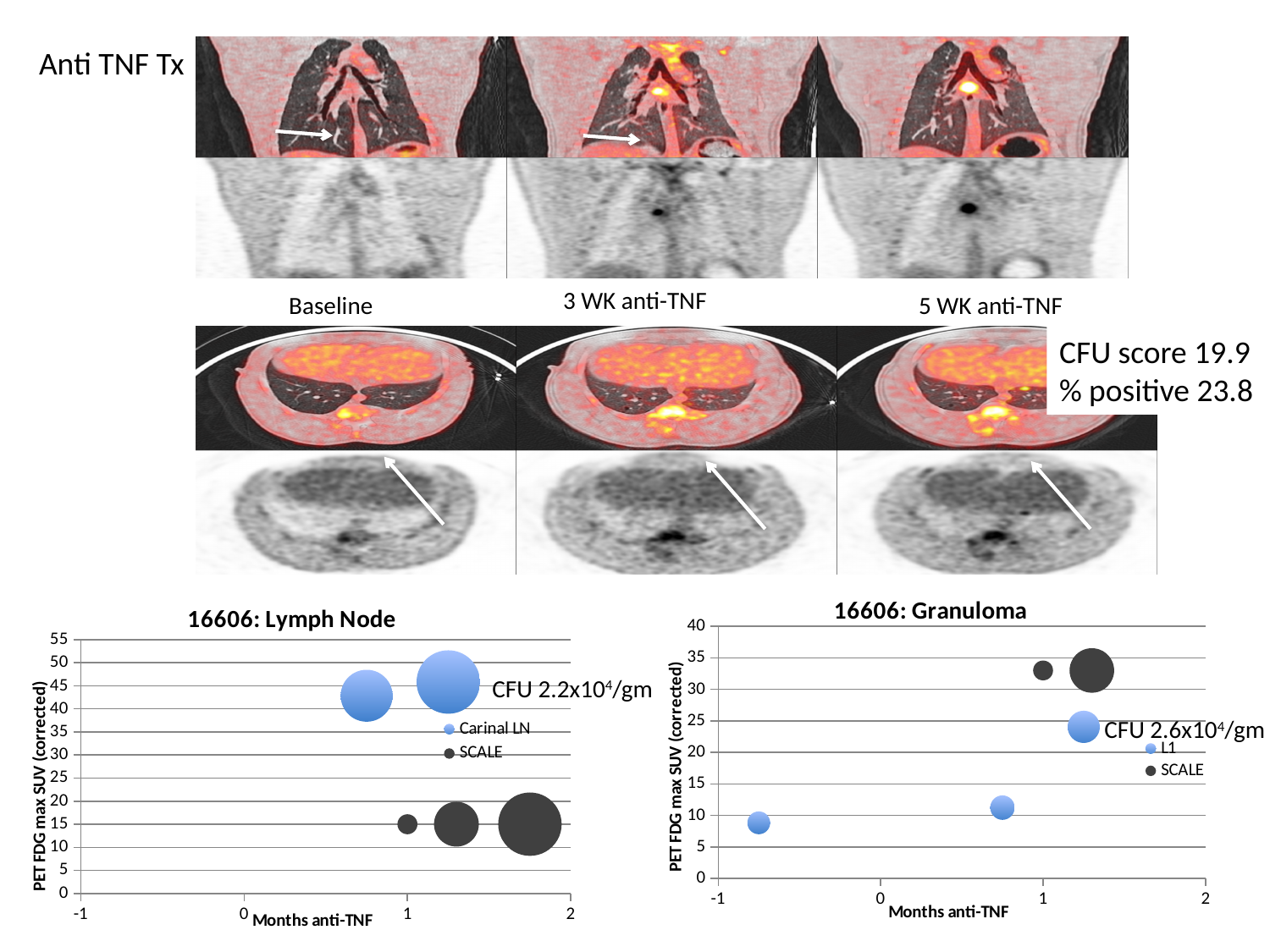
What kind of chart is the "16606: Lymph Node" chart? bubble chart In the "16606: Granuloma" chart, is the L1 value at about 1.25 months greater or less than 20? greater In the "16606: Granuloma" chart, which series has the higher plotted values, L1 or SCALE? SCALE What are the two legend entries on the "16606: Lymph Node" chart? Carinal LN and SCALE In the "16606: Lymph Node" chart, are the SCALE bubbles plotted above or below 20 on the y-axis? below In the "16606: Lymph Node" chart, are the Carinal LN values greater or less than 40? greater In the "16606: Granuloma" chart, do the L1 values rise or fall as months anti-TNF increase? rise In the "16606: Granuloma" chart, how many L1 (blue) bubbles are plotted? 3 How many series does the legend of the "16606: Granuloma" chart list? 2 What is the y-axis label on the "16606: Granuloma" chart? PET FDG max SUV (corrected) In the "16606: Lymph Node" chart, how many SCALE (dark) bubbles are plotted? 3